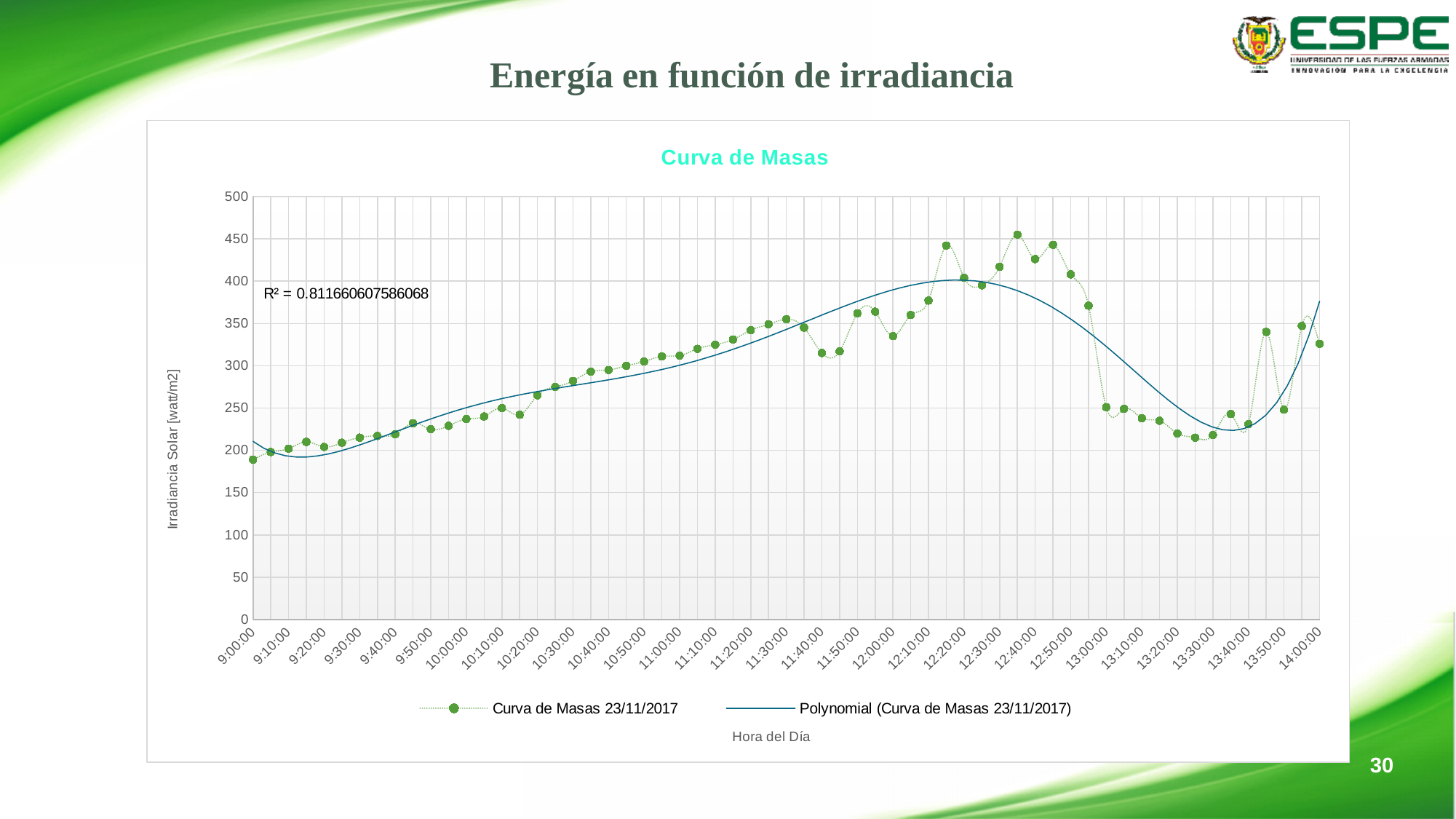
How many series does the chart legend list? 2 At which time of day does the Curva de Masas 23/11/2017 series have its lowest value? 9:00:00 What is the title of the chart? Curva de Masas Is the value of the Curva de Masas 23/11/2017 series at 11:00:00 greater or less than 300? greater What is the label of the y axis? Irradiancia Solar [watt/m2] Is the value of the Curva de Masas 23/11/2017 series at 13:30:00 greater or less than 250? less Is the value of the Curva de Masas 23/11/2017 series at 9:00:00 greater or less than 200? less What kind of chart is shown on the slide? Line chart Do the values of the Curva de Masas 23/11/2017 series generally rise or fall between 9:00:00 and 12:40:00? rise Which has the larger value in the Curva de Masas 23/11/2017 series, 11:00:00 or 13:30:00? 11:00:00